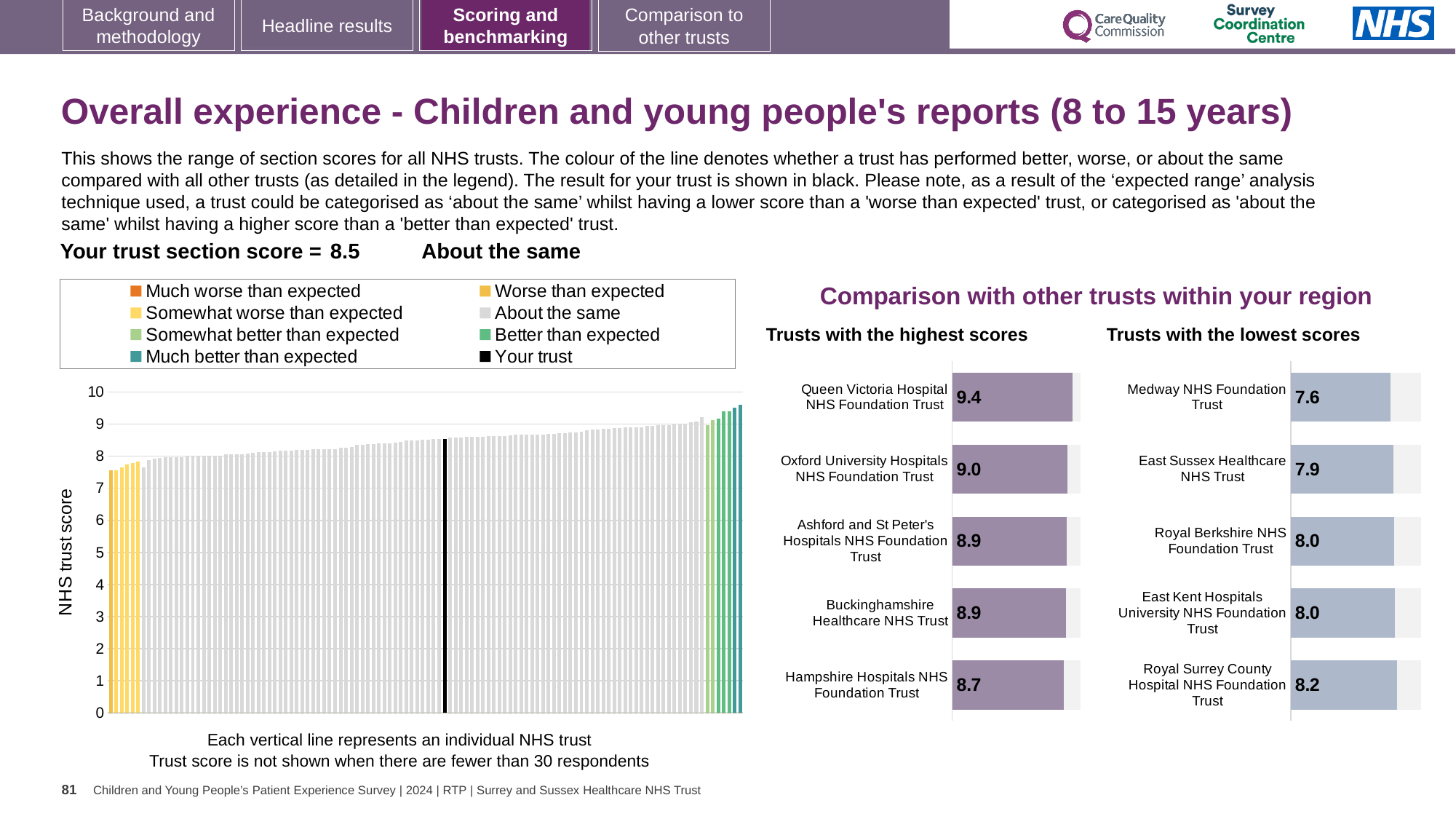
In the 'Trusts with the highest scores' chart, what is the difference between the scores of Queen Victoria Hospital NHS Foundation Trust and Hampshire Hospitals NHS Foundation Trust? 0.7 Which has a higher score: Oxford University Hospitals NHS Foundation Trust in the highest scores chart or Royal Surrey County Hospital NHS Foundation Trust in the lowest scores chart? Oxford University Hospitals NHS Foundation Trust In the 'Trusts with the highest scores' chart, what is the score for Queen Victoria Hospital NHS Foundation Trust? 9.4 In the 'Trusts with the lowest scores' chart, what is the score for Royal Surrey County Hospital NHS Foundation Trust? 8.2 In the 'Trusts with the highest scores' chart, which trust has the highest score? Queen Victoria Hospital NHS Foundation Trust In the 'Trusts with the lowest scores' chart, which trust has the lowest score? Medway NHS Foundation Trust In the 'Trusts with the lowest scores' chart, what is the difference between the scores of Royal Surrey County Hospital NHS Foundation Trust and Medway NHS Foundation Trust? 0.6 In the main NHS trust score chart on the left, do the bar values rise or fall from left to right? rise In the 'Trusts with the lowest scores' chart, what is the score for Medway NHS Foundation Trust? 7.6 In the 'Trusts with the highest scores' chart, what is the score for Hampshire Hospitals NHS Foundation Trust? 8.7 How many trusts are shown in the 'Trusts with the lowest scores' chart? 5 How many entries does the legend of the main NHS trust score chart on the left list? 8